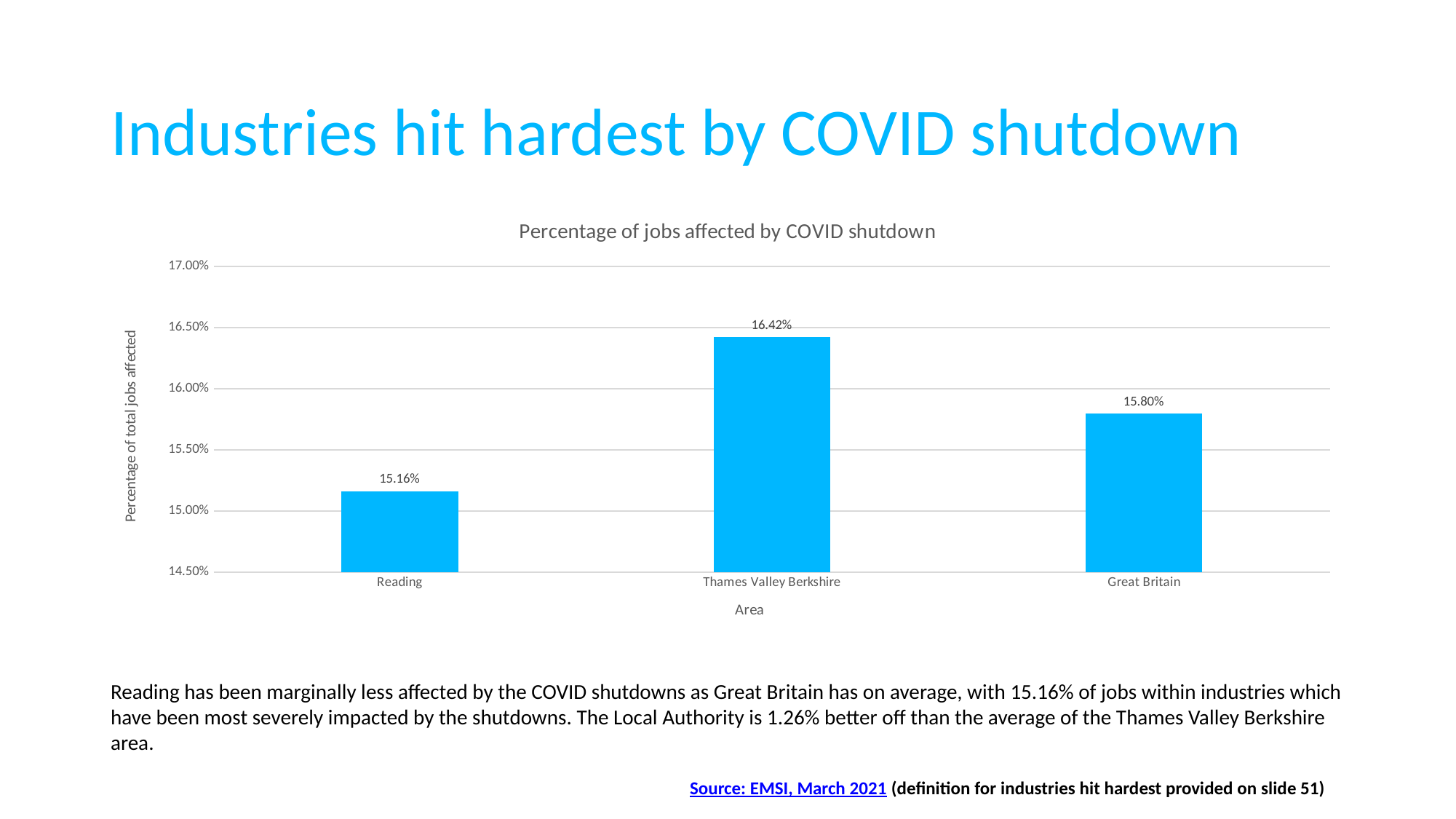
What is the value for Thames Valley Berkshire? 16.42% What is the title of the chart? Percentage of jobs affected by COVID shutdown What is the difference between the values for Great Britain and Reading? 0.64% How many areas are shown on the chart? 3 What is the value for Great Britain? 15.80% Is the value for Thames Valley Berkshire greater or less than 16.00%? greater Which is larger, the value for Great Britain or the value for Reading? Great Britain What kind of chart is shown on the slide? Bar chart What is the difference between the values for Thames Valley Berkshire and Reading? 1.26% What is the value for Reading? 15.16% Which area has the lowest percentage of jobs affected by COVID shutdown? Reading Which area has the highest percentage of jobs affected by COVID shutdown? Thames Valley Berkshire